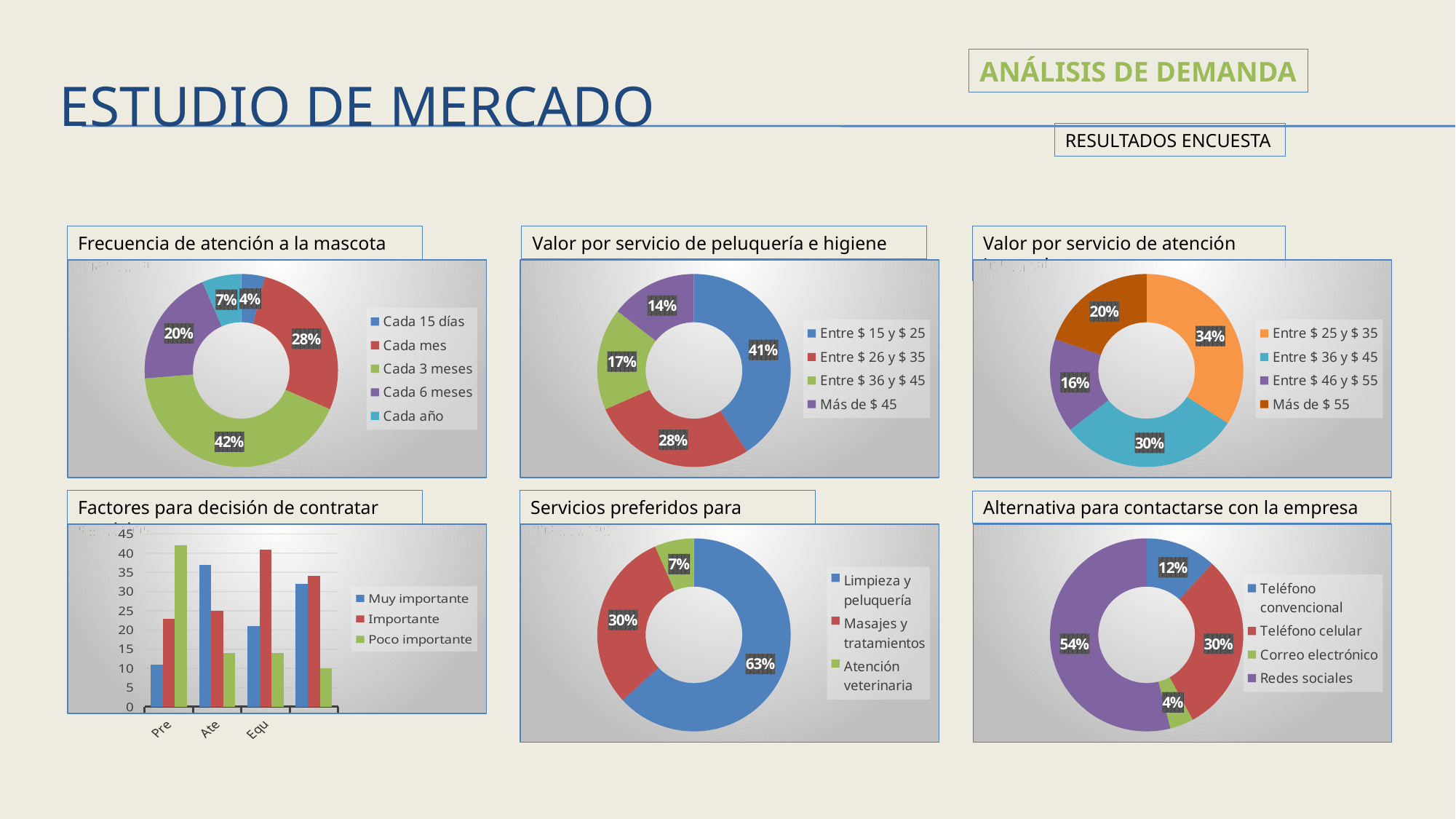
In the 'Frecuencia de atención a la mascota' chart, which category has the smallest share? Cada 15 días In the 'Frecuencia de atención a la mascota' chart, what percentage corresponds to 'Cada 3 meses'? 42% What kind of chart is 'Factores para decisión de contratar'? Bar chart In the 'Servicios preferidos para...' chart, what is the share for 'Masajes y tratamientos'? 30% In the 'Factores para decisión de contratar' chart, is the 'Poco importante' value for 'Pre' greater or less than 40? greater In the 'Valor por servicio de peluquería e higiene' chart, what is the difference between the shares for 'Entre $ 26 y $ 35' and 'Más de $ 45'? 14% How many series does the legend of the 'Factores para decisión de contratar' chart list? 3 In the 'Valor por servicio de peluquería e higiene' chart, what is the share for 'Entre $ 15 y $ 25'? 41% In the 'Alternativa para contactarse con la empresa' chart, which is larger: 'Teléfono convencional' or 'Teléfono celular'? Teléfono celular In the 'Factores para decisión de contratar' chart, is the 'Muy importante' value for 'Pre' greater or less than 15? less In the top-right doughnut chart ('Valor por servicio de atención...'), what is the share for 'Más de $ 55'? 20% In the top-right doughnut chart ('Valor por servicio de atención...'), which category has the largest share? Entre $ 25 y $ 35